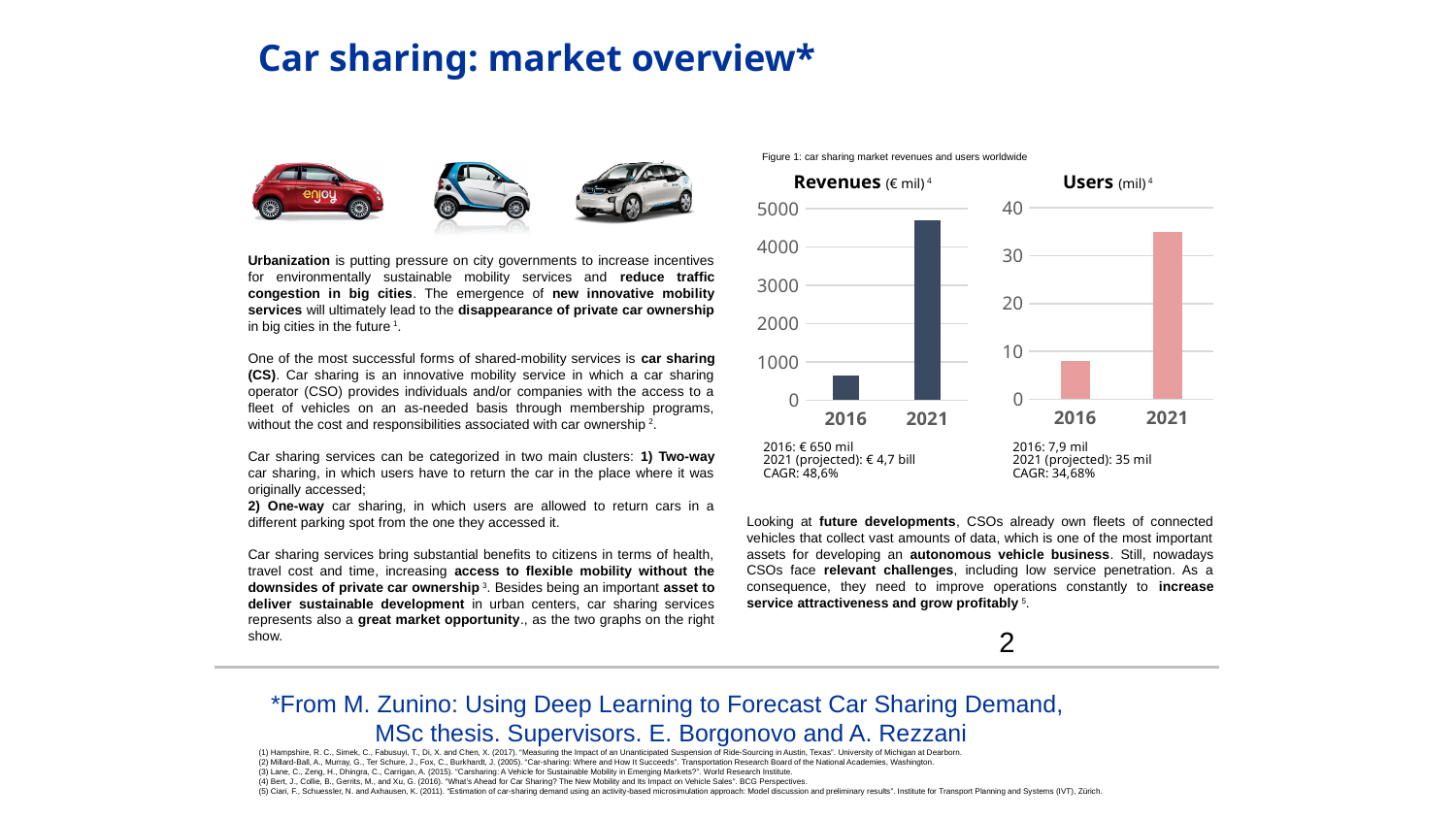
In the Revenues chart, is the value for 2021 greater or less than 4000? greater According to the note under the Revenues chart, what is the revenue value for 2016? € 650 mil What kind of chart is the Revenues chart? bar chart In the Users chart, is the value for 2021 greater or less than 30? greater How many categories are shown on the x axis of the Users chart? 2 What unit is given in the title of the Revenues chart? € mil In the Users chart, which year has the lower bar? 2016 In the Users chart, is the value for 2016 greater or less than 10? less Do the values in the Users chart rise or fall from 2016 to 2021? rise According to the note under the Users chart, what is the projected number of users for 2021? 35 mil In the Revenues chart, which year has the higher bar? 2021